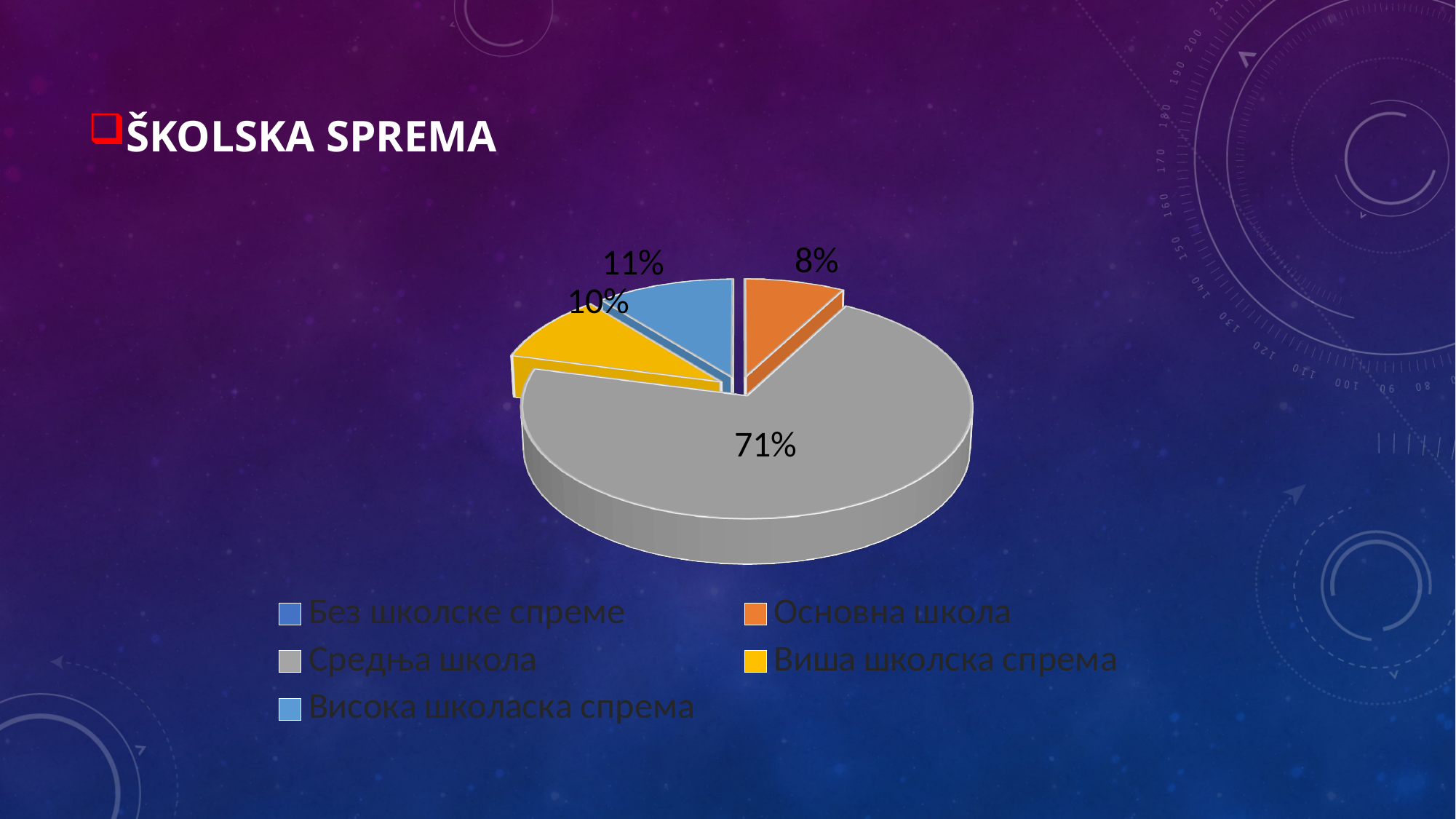
What is the difference in percentage points between the Средња школа slice and the Основна школа slice? 63 What colour is the Средња школа slice? gray How many entries does the legend list? 5 What percentage does the Средња школа slice represent? 71% What percentage does the Висока школаска спрема slice represent? 11% Which category has the largest share of the pie? Средња школа What type of chart is shown on the slide? pie chart How many slices have a percentage label printed on the chart? 4 Which of the labeled slices is the smallest? Основна школа Which is larger, the Виша школска спрема slice or the Висока школаска спрема slice? Висока школаска спрема What percentage does the Основна школа slice represent? 8% What percentage does the Виша школска спрема slice represent? 10%